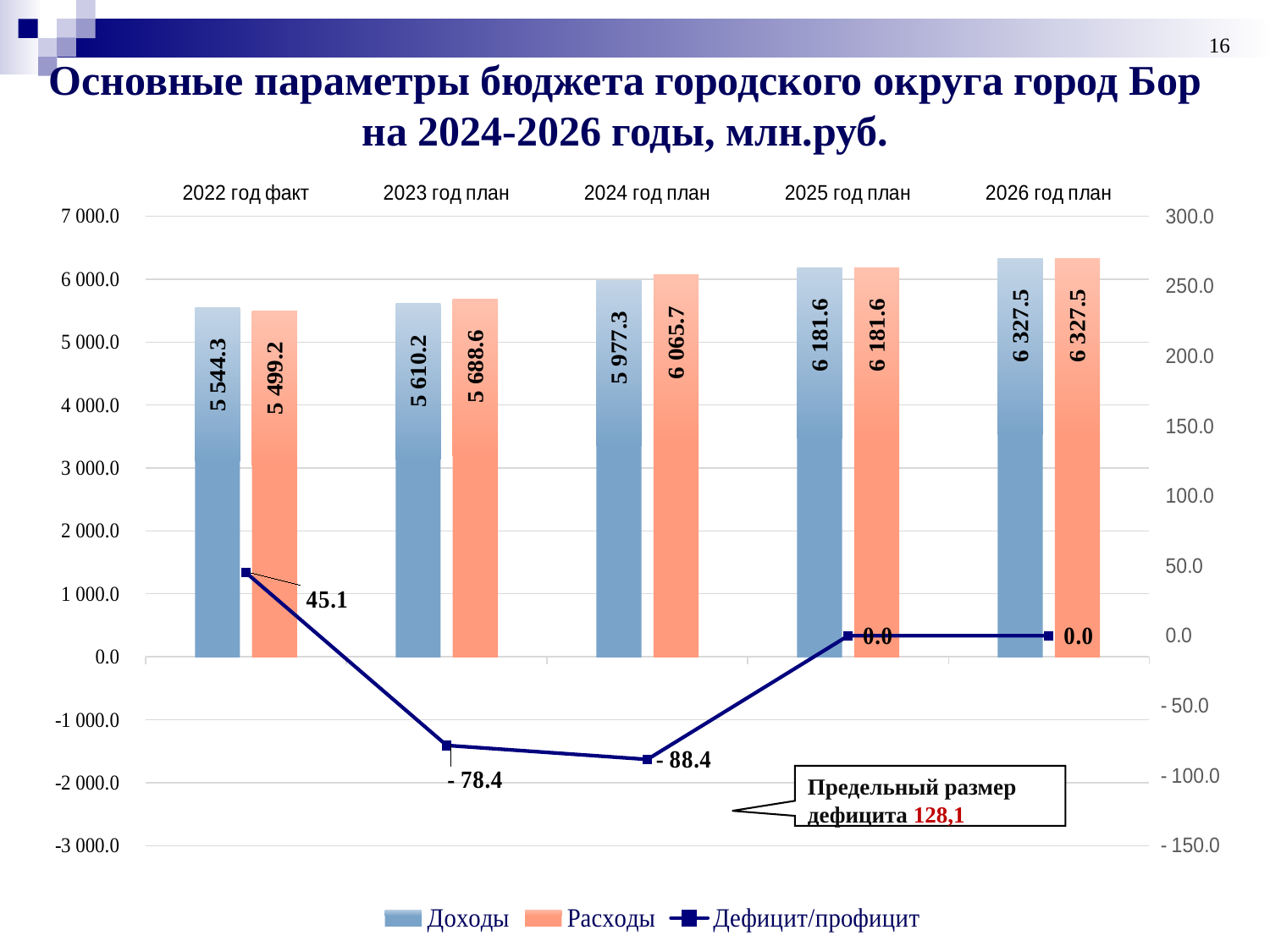
How many year categories are shown on the x axis? 5 Which year has the highest value of Доходы? 2026 год план What is the value of Доходы for 2022 год факт? 5 544.3 How many series does the legend list? 3 Do the Доходы values rise or fall from 2022 год факт to 2026 год план? rise Which year has the lowest value of Расходы? 2022 год факт What value is given for Предельный размер дефицита in the callout box? 128,1 Which is larger for 2022 год факт: Доходы or Расходы? Доходы What is the value of Расходы for 2024 год план? 6 065.7 What is the value of Дефицит/профицит for 2023 год план? - 78.4 What is the difference between Расходы and Доходы for 2023 год план? 78.4 What is the value of Расходы for 2026 год план? 6 327.5